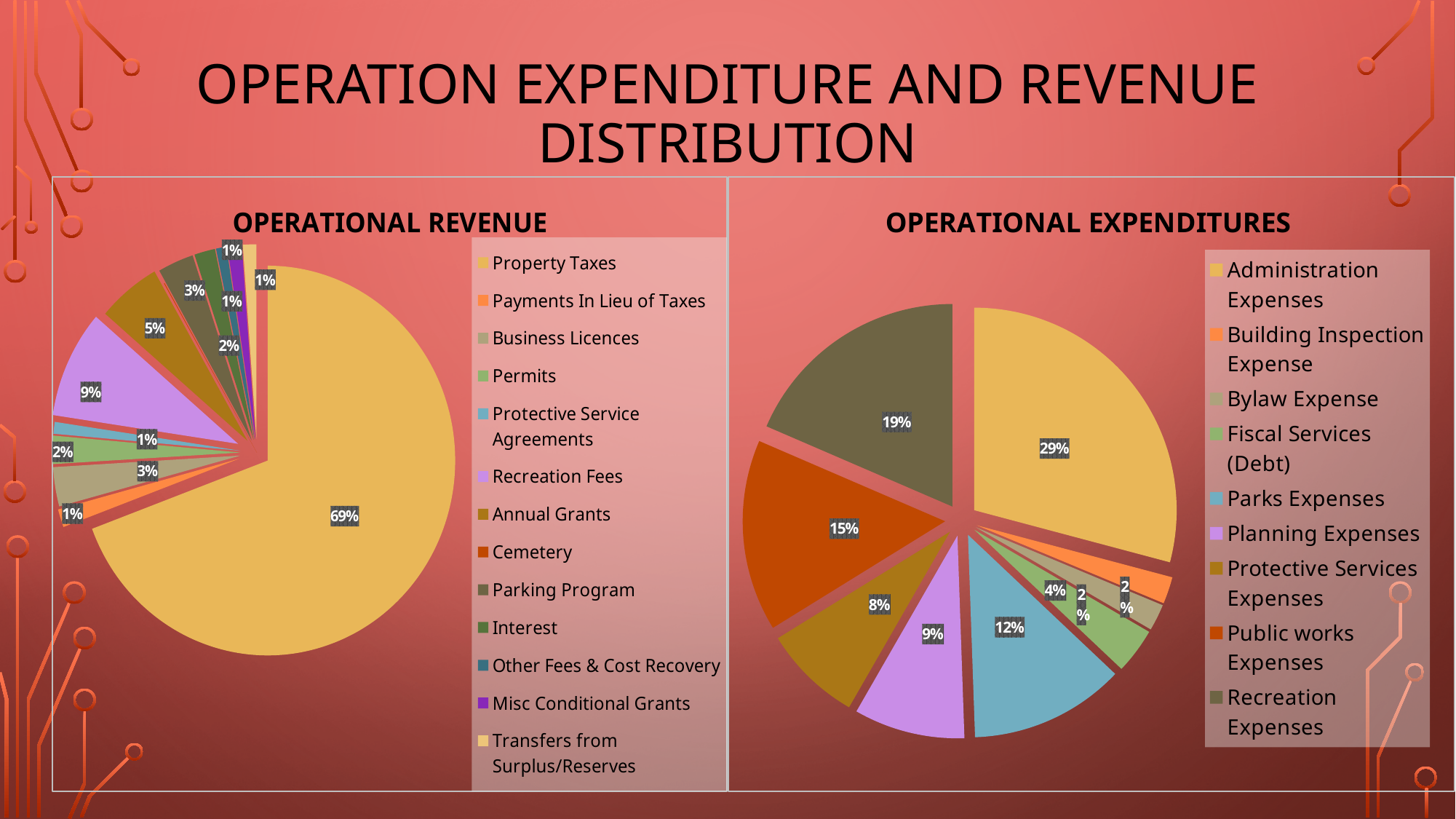
In the Operational Revenue chart, what share of revenue comes from Property Taxes? 69% In the Operational Revenue chart, which category has the largest slice? Property Taxes In the Operational Revenue chart, what percentage is Annual Grants? 5% In the Operational Expenditures chart, what percentage is Administration Expenses? 29% In the Operational Expenditures chart, which category has the largest share? Administration Expenses How many entries does the legend of the Operational Revenue chart list? 13 What type of chart is the Operational Expenditures chart? Pie chart In the Operational Expenditures chart, what percentage is Public works Expenses? 15% In the Operational Expenditures chart, what percentage is Parks Expenses? 12% In the Operational Expenditures chart, what is the difference between Recreation Expenses and Planning Expenses? 10% In the Operational Revenue chart, what percentage is Recreation Fees? 9% In the Operational Expenditures chart, which is larger, Protective Services Expenses or Parks Expenses? Parks Expenses